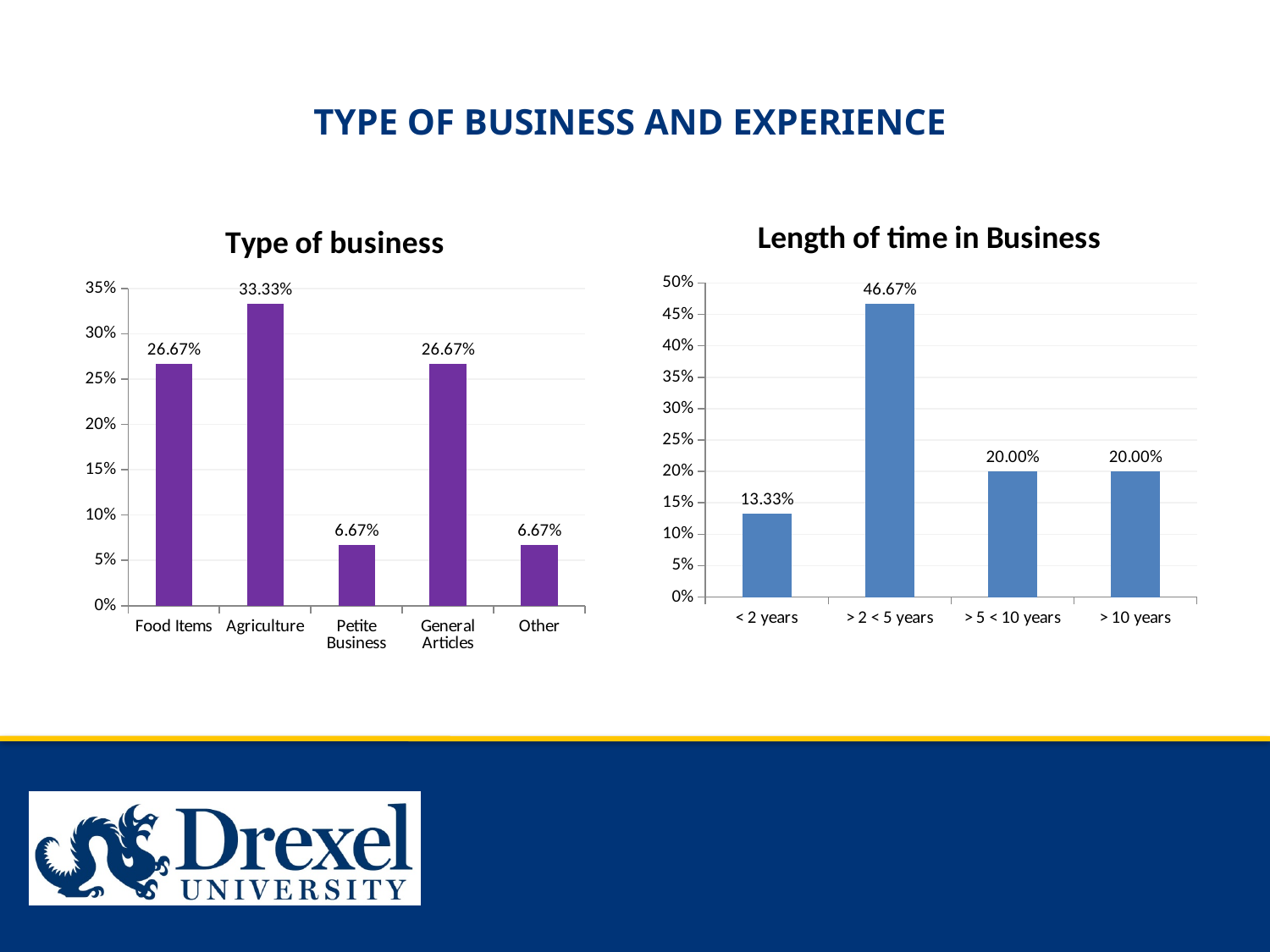
In the 'Length of time in Business' chart, which is larger: > 2 < 5 years or > 10 years? > 2 < 5 years In the 'Type of business' chart, which category has the highest value? Agriculture In the 'Type of business' chart, what is the value for Agriculture? 33.33% In the 'Type of business' chart, is the value for General Articles greater or less than 25%? greater In the 'Length of time in Business' chart, which category has the lowest value? < 2 years In the 'Type of business' chart, how many categories are shown? 5 In the 'Length of time in Business' chart, what is the value for > 2 < 5 years? 46.67% In the 'Type of business' chart, what is the difference between Agriculture and Food Items? 6.66% In the 'Length of time in Business' chart, what is the difference between > 2 < 5 years and < 2 years? 33.34% What kind of chart is the 'Length of time in Business' chart? Bar chart What colour are the bars in the 'Type of business' chart? Purple In the 'Type of business' chart, what is the value for Petite Business? 6.67%